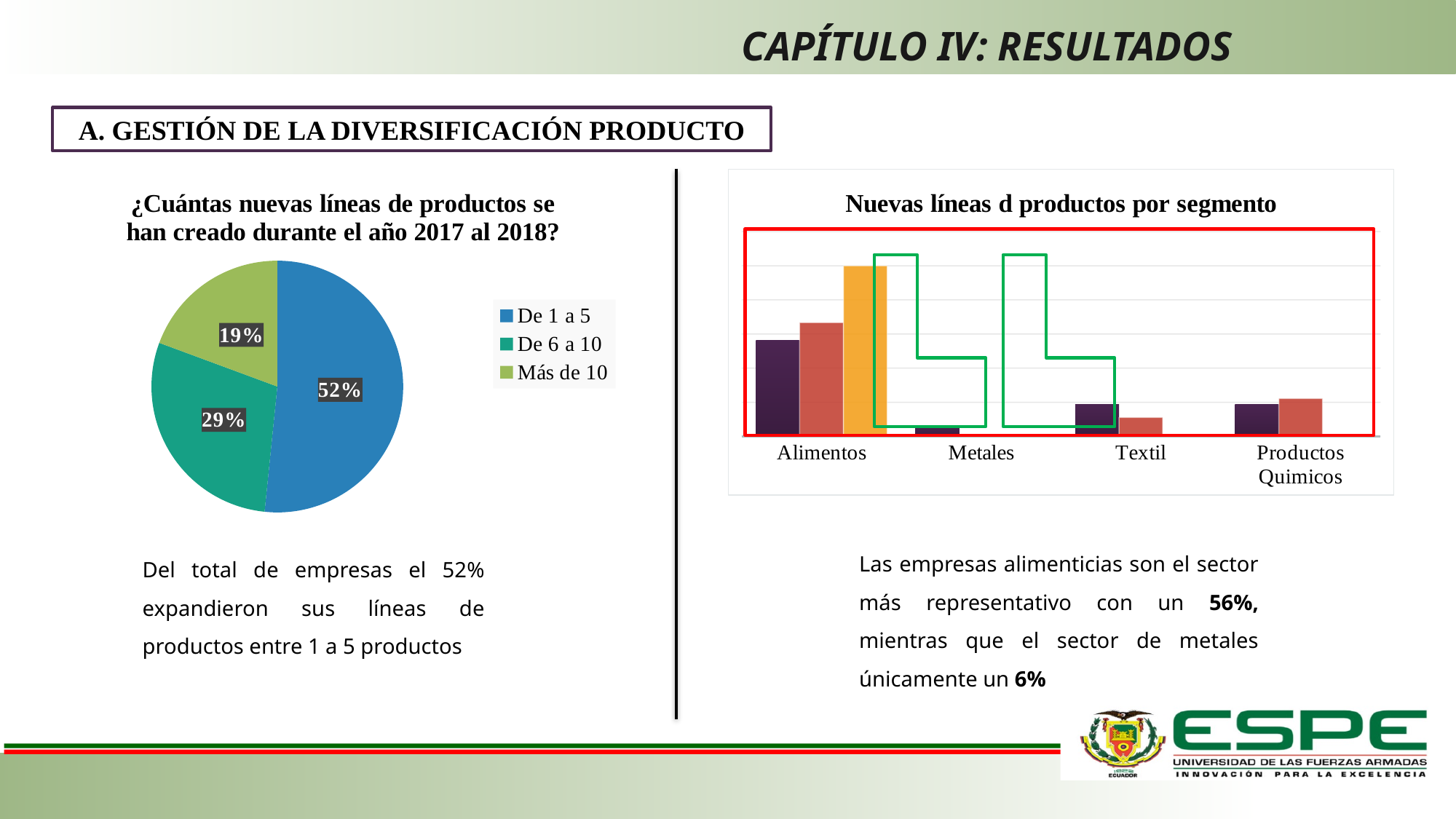
How many entries does the legend of the pie chart on the left list? 3 What type of chart is the chart on the left of the slide? Pie chart How many categories are shown on the x axis of the chart 'Nuevas líneas d productos por segmento'? 4 On the pie chart on the left, what percentage is shown for the 'Más de 10' slice? 19% On the pie chart on the left, what percentage is shown for the 'De 1 a 5' slice? 52% On the pie chart on the left, what percentage is shown for the 'De 6 a 10' slice? 29% On the pie chart on the left, what is the difference in percentage points between the 'De 1 a 5' slice and the 'De 6 a 10' slice? 23 On the pie chart on the left, which is larger: the 'De 6 a 10' slice or the 'Más de 10' slice? De 6 a 10 What type of chart is 'Nuevas líneas d productos por segmento'? Bar chart On the pie chart on the left, which category has the smallest share? Más de 10 In the chart 'Nuevas líneas d productos por segmento', which category has the tallest bar? Alimentos On the pie chart on the left, which category has the largest share? De 1 a 5